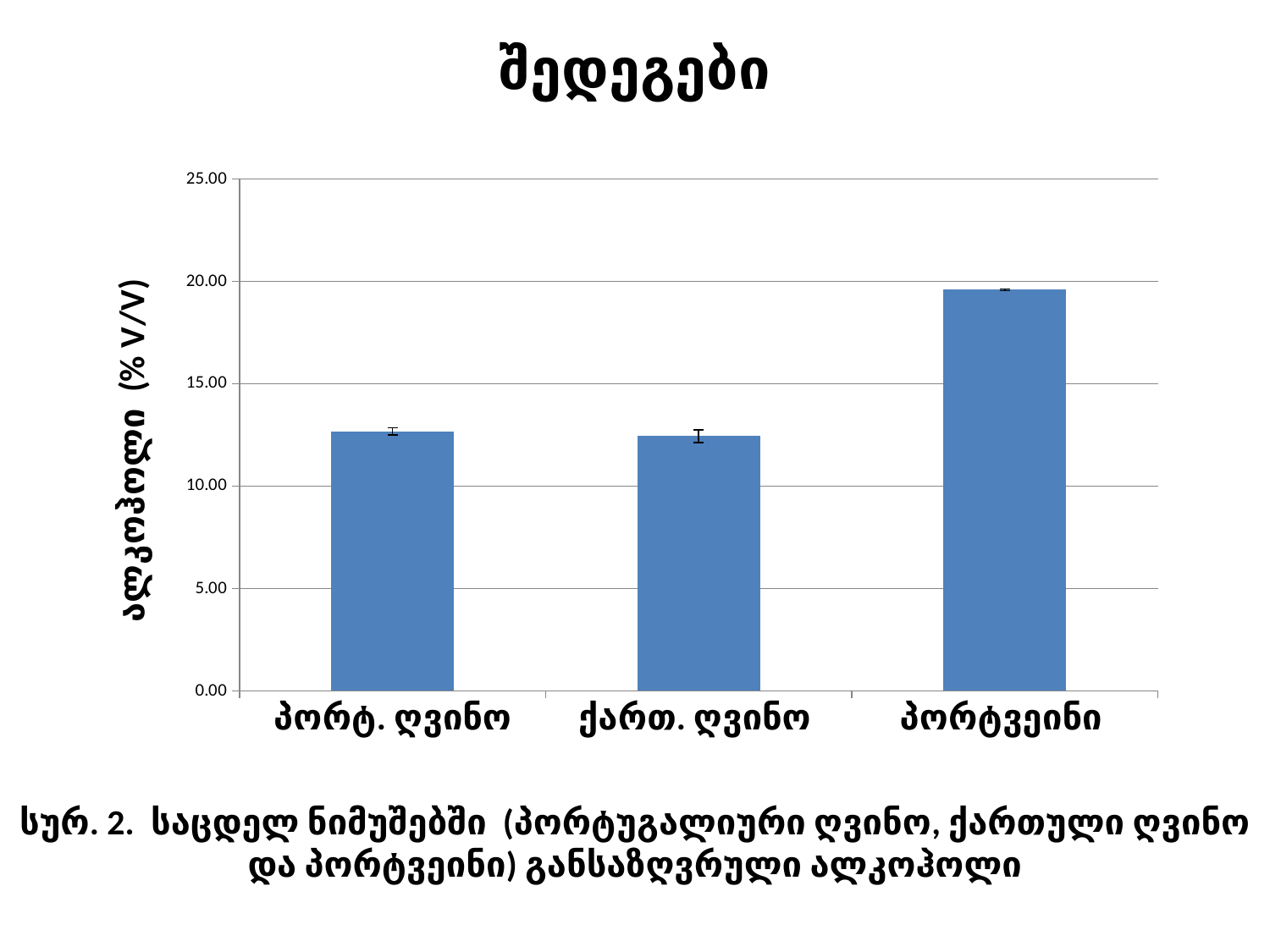
What is the title shown above the chart? შედეგები Is the value for ქართ. ღვინო greater or less than 15.00? less Which is larger, the value for ქართ. ღვინო or the value for პორტვეინი? პორტვეინი Which category has the highest alcohol value in the chart? პორტვეინი How many categories are shown on the x axis of the chart? 3 What kind of chart is shown on the slide? bar chart Is the value for პორტვეინი greater or less than 15.00? greater Is the value for პორტვეინი greater or less than 20.00? less Which is larger, the value for პორტვეინი or the value for პორტ. ღვინო? პორტვეინი What is the label of the y axis of the chart? ალკოჰოლი (% V/V)